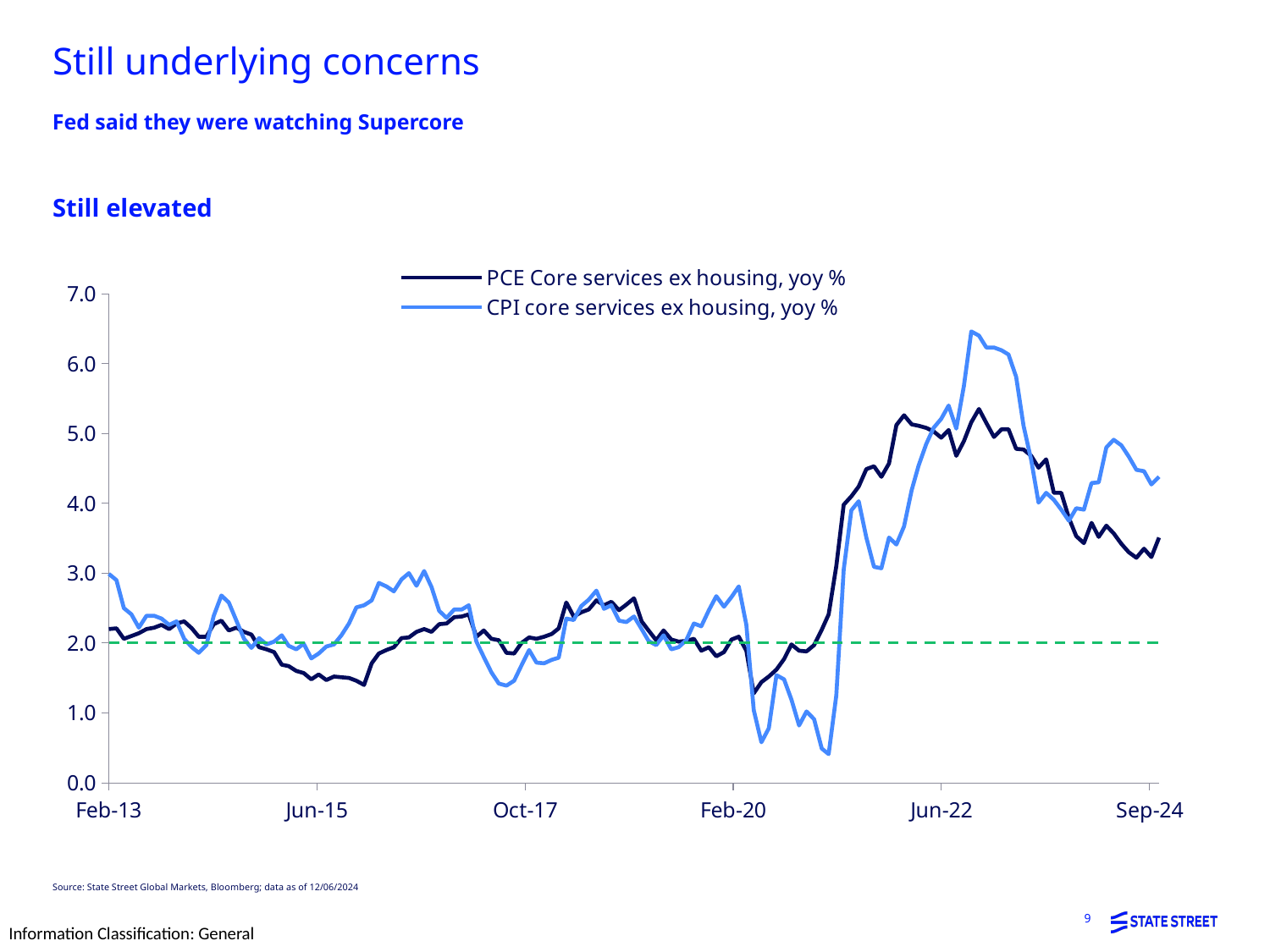
Between Jun-22 and Sep-24, does PCE Core services ex housing, yoy % generally rise or fall? fall How many date labels are shown on the x axis? 6 What is the title of the chart? Still elevated Is the peak value of PCE Core services ex housing, yoy % greater or less than 6.0? less At Sep-24, which series has the higher value? CPI core services ex housing, yoy % Is the lowest value of CPI core services ex housing, yoy % (around 2021) greater or less than 1.0? less How many series does the chart legend list? 2 Is the peak value of CPI core services ex housing, yoy % greater or less than 6.0? greater At what level is the dashed green horizontal reference line drawn? 2.0 Which series reaches the higher peak value on the chart? CPI core services ex housing, yoy % What type of chart is shown on the slide? line chart